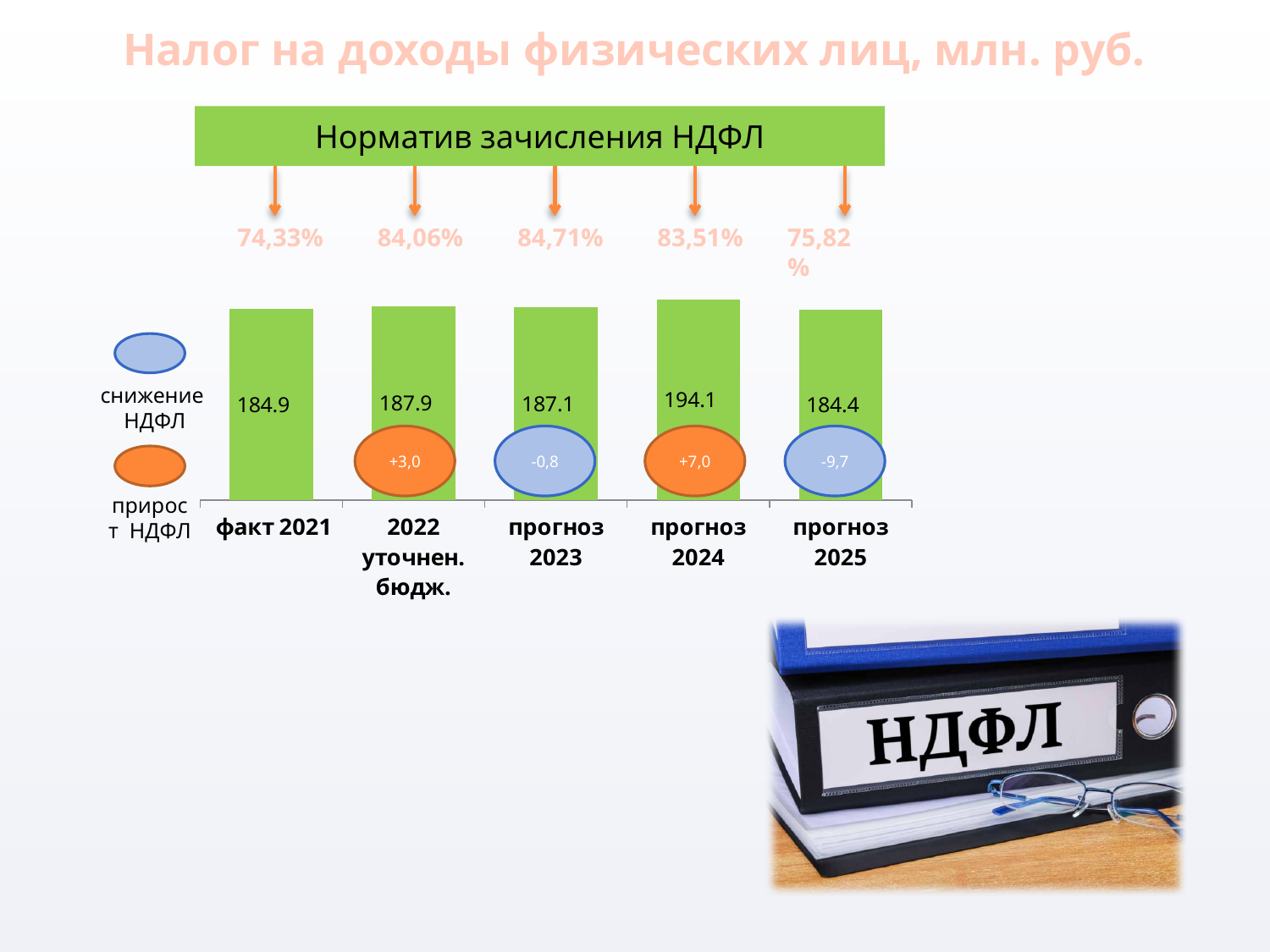
Which category has the lowest value? прогноз 2025 Which is larger, the value for прогноз 2023 or the value for 2022 уточнен. бюдж.? 2022 уточнен. бюдж. What is the difference between the values for 2022 уточнен. бюдж. and факт 2021? 3.0 What is the value for прогноз 2025? 184.4 What is the value for 2022 уточнен. бюдж.? 187.9 How many bars are shown in the chart? 5 What is the value for прогноз 2024? 194.1 What kind of chart is shown on the slide? bar chart Which category has the highest value? прогноз 2024 What is the difference between the values for прогноз 2024 and прогноз 2023? 7.0 What is the value for факт 2021? 184.9 What is the title of the slide? Налог на доходы физических лиц, млн. руб.